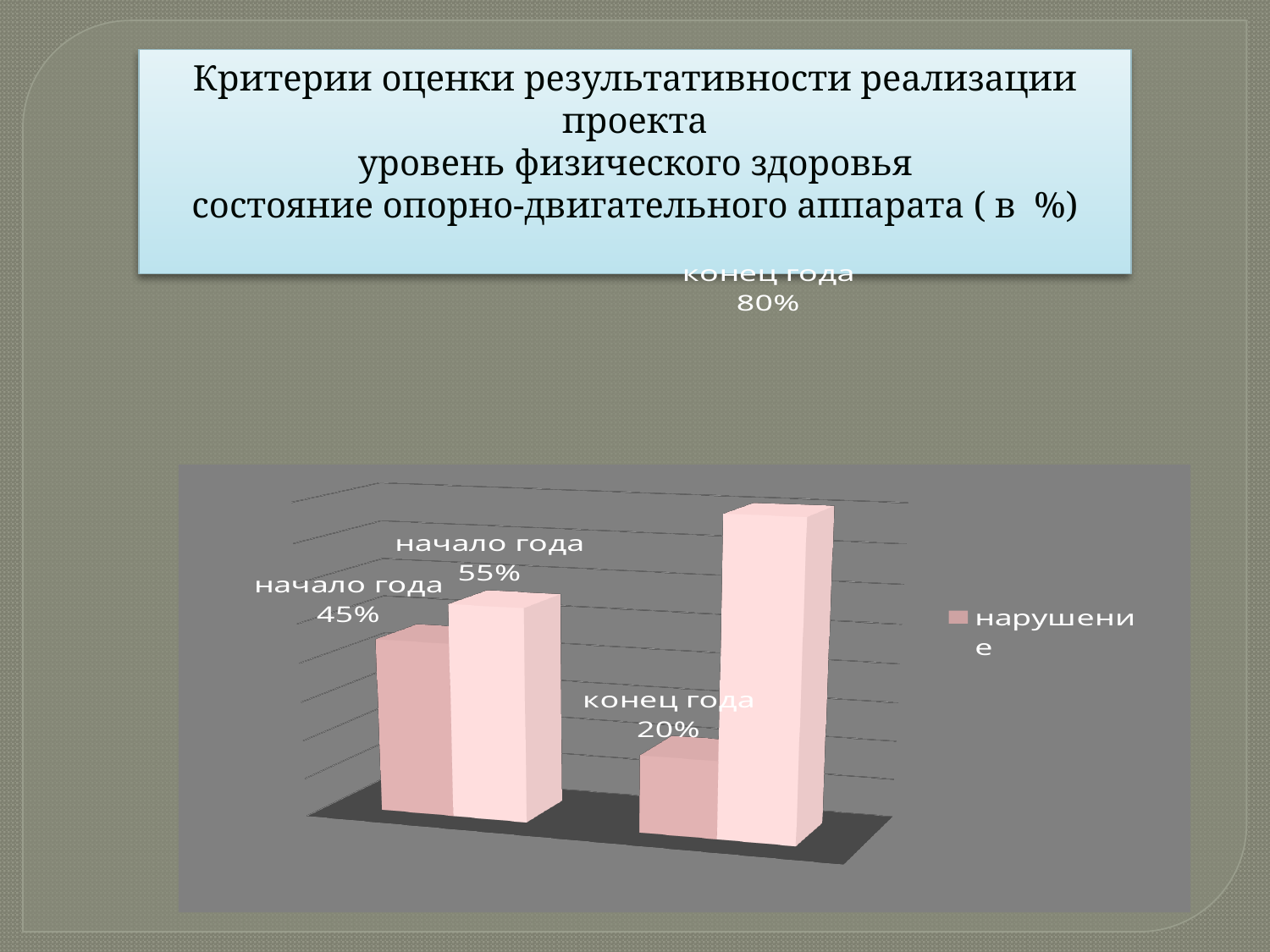
Which data label shows the lowest value on the chart? 20% (конец года) What is the value shown by the lighter pink bar for "конец года"? 80% What is the value of the "нарушение" series for "начало года"? 45% Does the "нарушение" series rise or fall from "начало года" to "конец года"? fall For the "нарушение" series, which category has the larger value, "начало года" or "конец года"? начало года What is the value of the "нарушение" series for "конец года"? 20% What series name is shown in the chart legend? нарушение By how much does the "нарушение" value for "начало года" exceed the value for "конец года"? 25% Which data label shows the highest value on the chart? 80% (конец года) What kind of chart is shown on the slide? bar chart What is the value shown by the lighter pink bar for "начало года"? 55% How many categories are shown on the x axis of the chart? 2